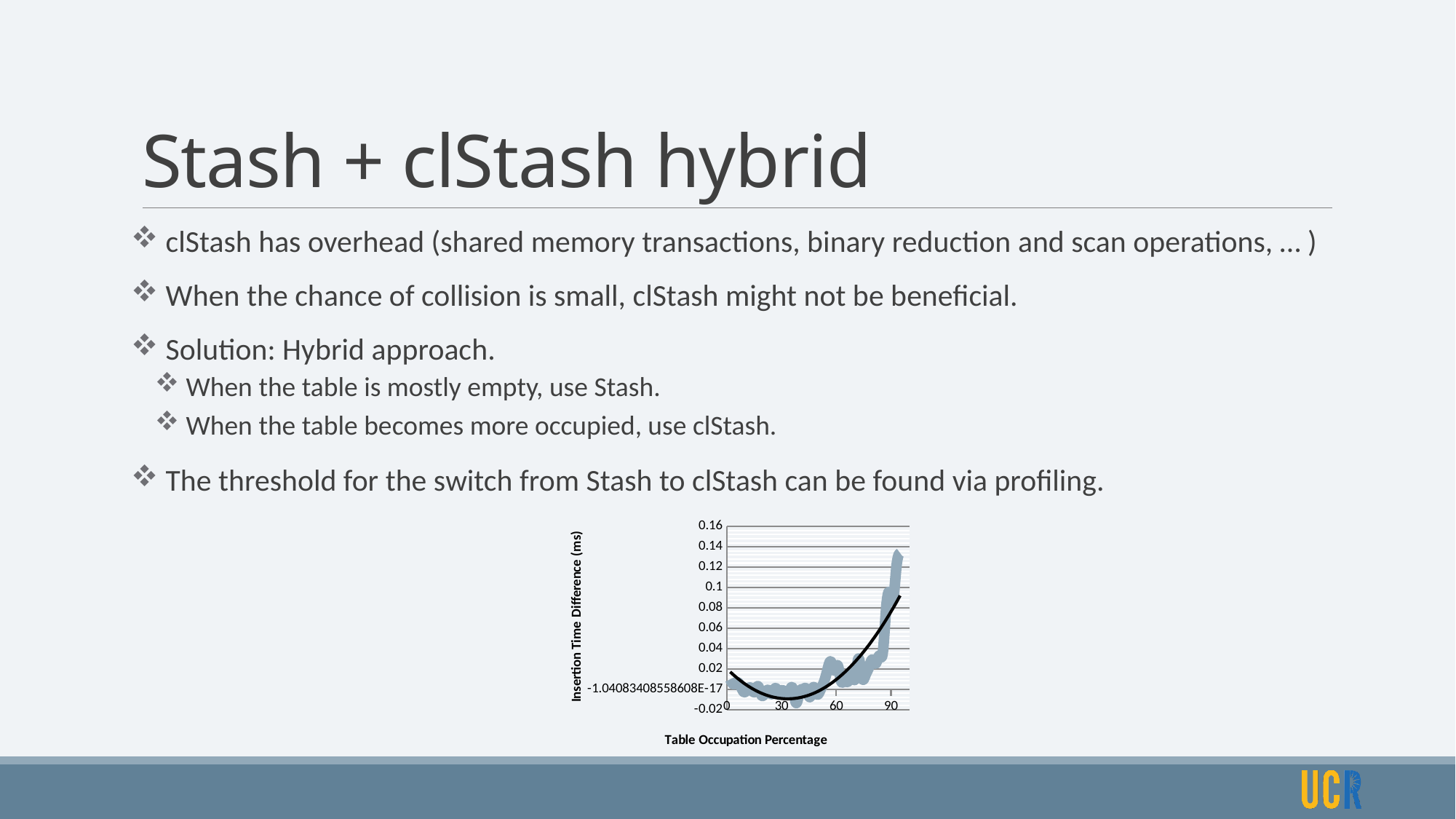
What is the title of the y axis of the chart? Insertion Time Difference (ms) Is the plotted Insertion Time Difference at a Table Occupation Percentage of 30 greater or less than 0.06? less What is the title of the x axis of the chart? Table Occupation Percentage How many labelled tick marks are shown on the x axis of the chart? 4 Which has the larger plotted Insertion Time Difference: a Table Occupation Percentage of 30 or of 90? 90 What is the highest value labelled on the y axis of the chart? 0.16 Is the highest plotted Insertion Time Difference value greater or less than 0.1? greater Is the plotted Insertion Time Difference at a Table Occupation Percentage of 30 greater or less than 0.02? less Overall, do the plotted values rise or fall as Table Occupation Percentage increases from 60 to 90 and beyond? rise What kind of chart is shown on the slide? scatter chart with a trend line